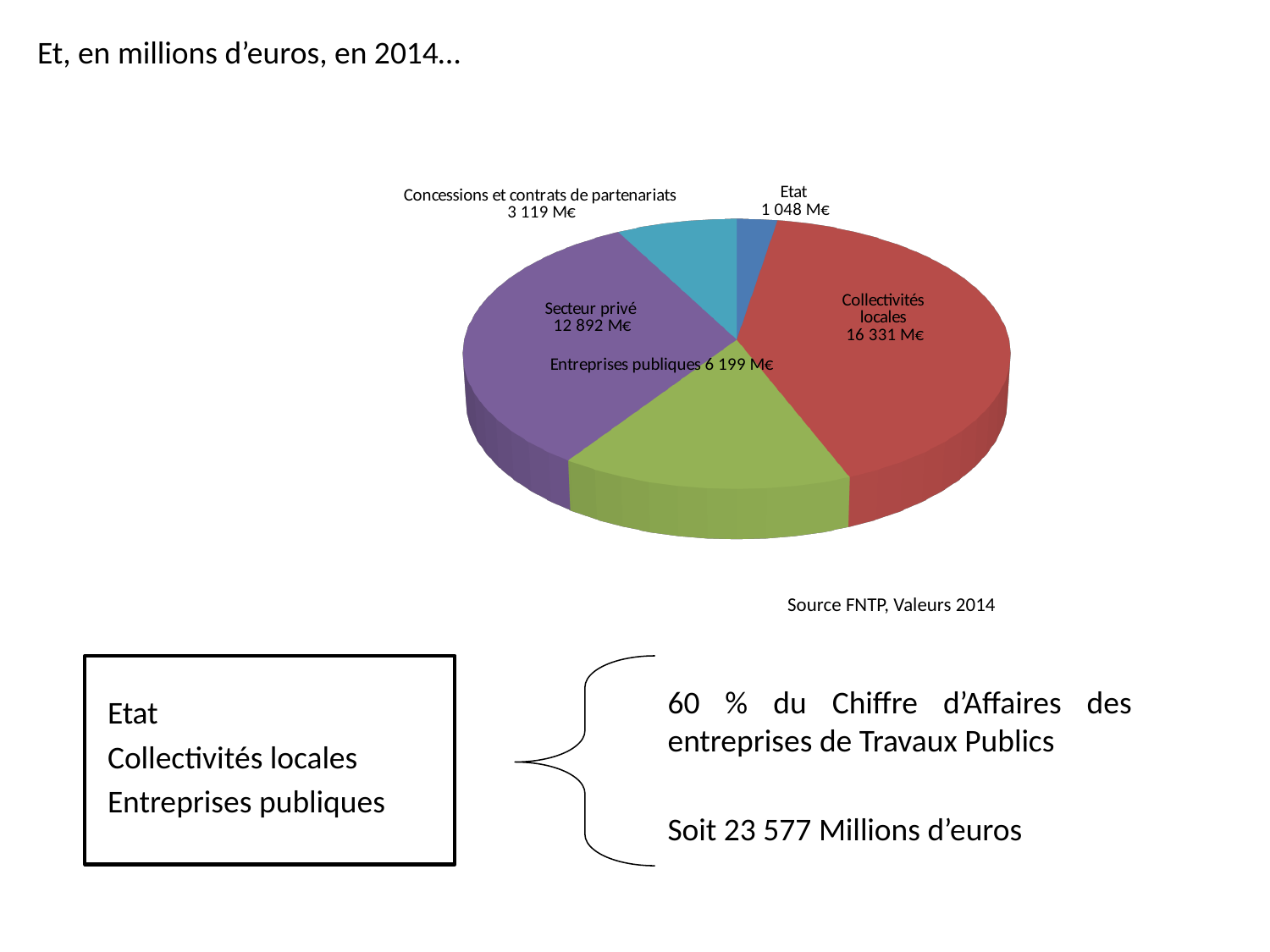
What is the difference between the values for Collectivités locales and Secteur privé? 3 439 M€ Which category has the largest slice in the pie chart? Collectivités locales Which category has the smallest slice in the pie chart? Etat What is the value for Collectivités locales in the pie chart? 16 331 M€ What colour is the Collectivités locales slice in the pie chart? Red Which is larger, the value for Secteur privé or the value for Entreprises publiques? Secteur privé What is the value for Entreprises publiques in the pie chart? 6 199 M€ What is the difference between the values for Entreprises publiques and Concessions et contrats de partenariats? 3 080 M€ What is the value for Concessions et contrats de partenariats in the pie chart? 3 119 M€ How many slices does the pie chart have? 5 What is the value for Secteur privé in the pie chart? 12 892 M€ What kind of chart is shown on the slide? Pie chart